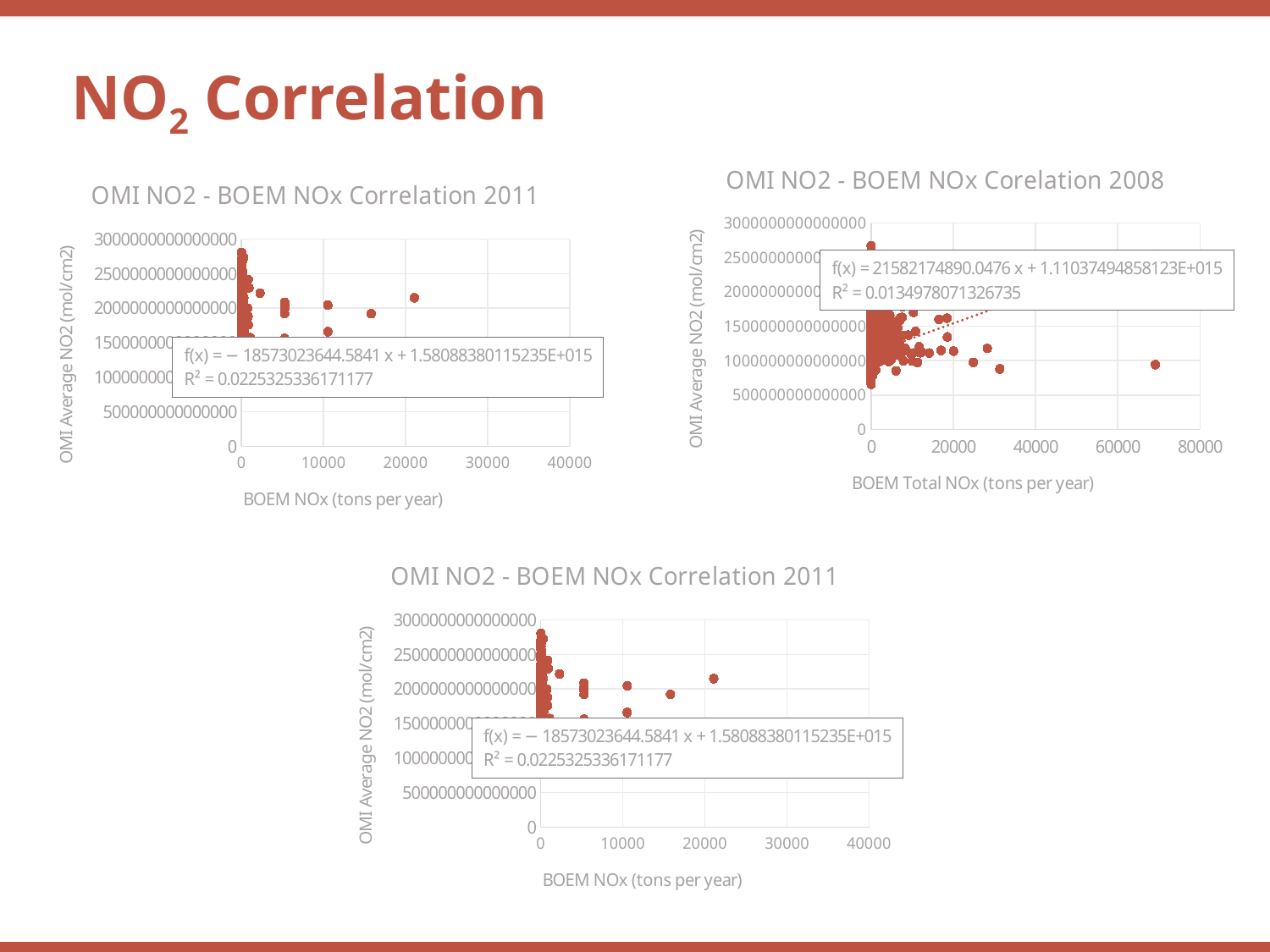
In the top-right chart "OMI NO2 - BOEM NOx Corelation 2008", does the dotted trendline rise or fall as BOEM Total NOx increases? Rise How many charts are shown on the slide? 3 In the top-left chart "OMI NO2 - BOEM NOx Correlation 2011", what is the R² value shown? 0.0225325336171177 What kind of chart is the top-left chart titled "OMI NO2 - BOEM NOx Correlation 2011"? Scatter chart Which chart has the larger R² value, the 2011 correlation chart or the 2008 correlation chart? The 2011 correlation chart In the bottom chart "OMI NO2 - BOEM NOx Correlation 2011", is the OMI Average NO2 value of the rightmost point (near 20000 tons per year) greater or less than 2000000000000000? greater In the top-right chart "OMI NO2 - BOEM NOx Corelation 2008", what is the slope coefficient in the trendline equation f(x)? 21582174890.0476 What is the title of the top-right chart? OMI NO2 - BOEM NOx Corelation 2008 In the top-right chart "OMI NO2 - BOEM NOx Corelation 2008", what is the R² value shown? 0.0134978071326735 In the top-right chart "OMI NO2 - BOEM NOx Corelation 2008", is the OMI Average NO2 value of the highest point (near 0 tons per year) greater or less than 2500000000000000? greater In the bottom chart "OMI NO2 - BOEM NOx Correlation 2011", what is the intercept in the trendline equation f(x)? 1.58088380115235E+015 What is the x-axis label of the top-right chart "OMI NO2 - BOEM NOx Corelation 2008"? BOEM Total NOx (tons per year)